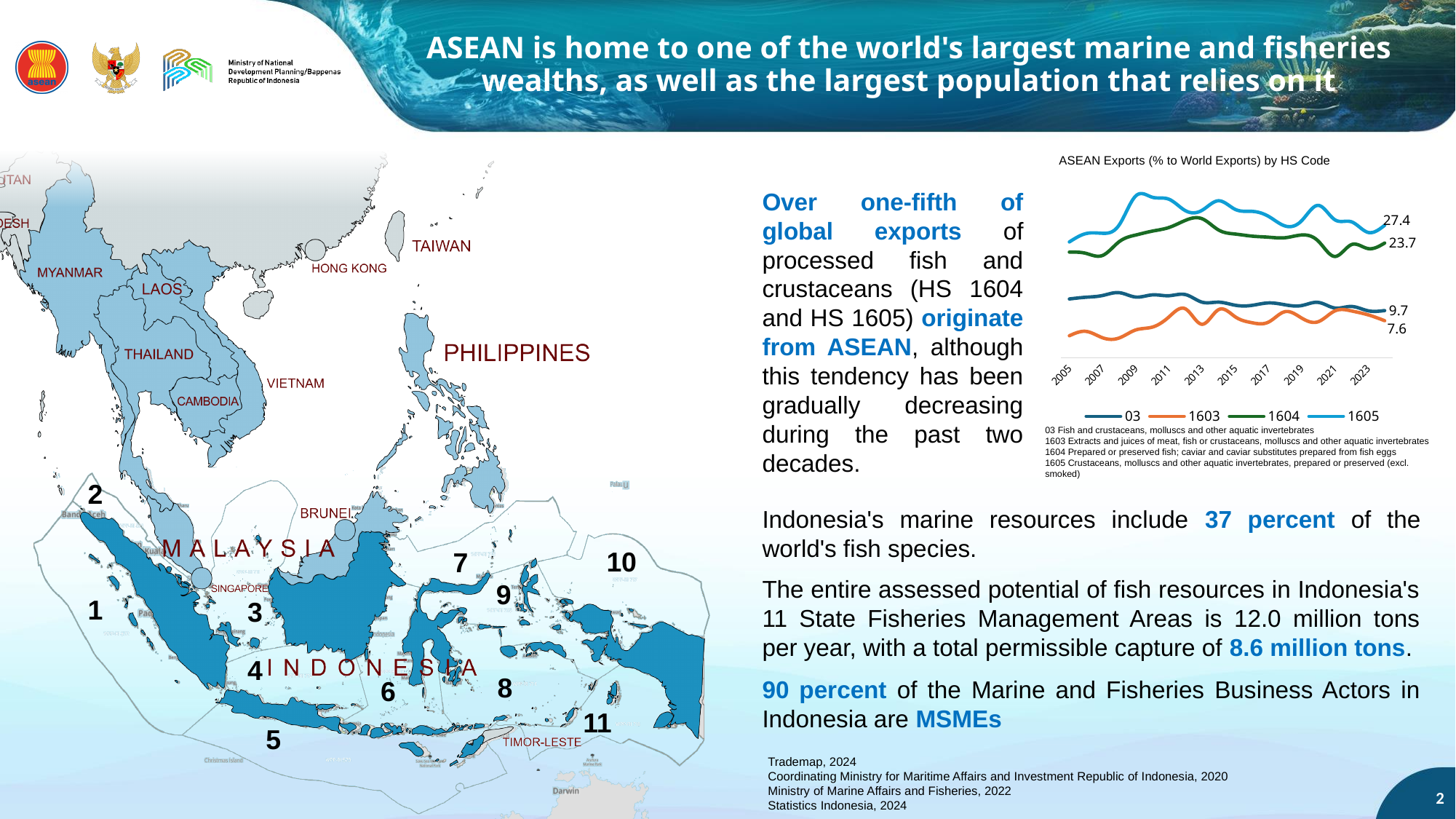
What is the last year shown on the x axis of the ASEAN Exports chart? 2023 In the ASEAN Exports chart, which HS code has the lowest value at the end of the series? 1603 In the ASEAN Exports chart, what is the difference between the final values of HS 03 and HS 1603? 2.1 In the ASEAN Exports chart, what is the final labelled value for HS code 1605? 27.4 How many series does the legend of the ASEAN Exports chart list? 4 In the ASEAN Exports chart, what is the difference between the final values of HS 1605 and HS 1604? 3.7 In the ASEAN Exports chart, what is the final labelled value for HS code 03? 9.7 What kind of chart is the 'ASEAN Exports (% to World Exports) by HS Code' chart? line chart In the ASEAN Exports chart, what is the final labelled value for HS code 1604? 23.7 In the ASEAN Exports chart, what is the final labelled value for HS code 1603? 7.6 In the ASEAN Exports chart, which HS code has the highest value at the end of the series? 1605 In the ASEAN Exports chart, which has the larger final value, HS 1604 or HS 03? 1604